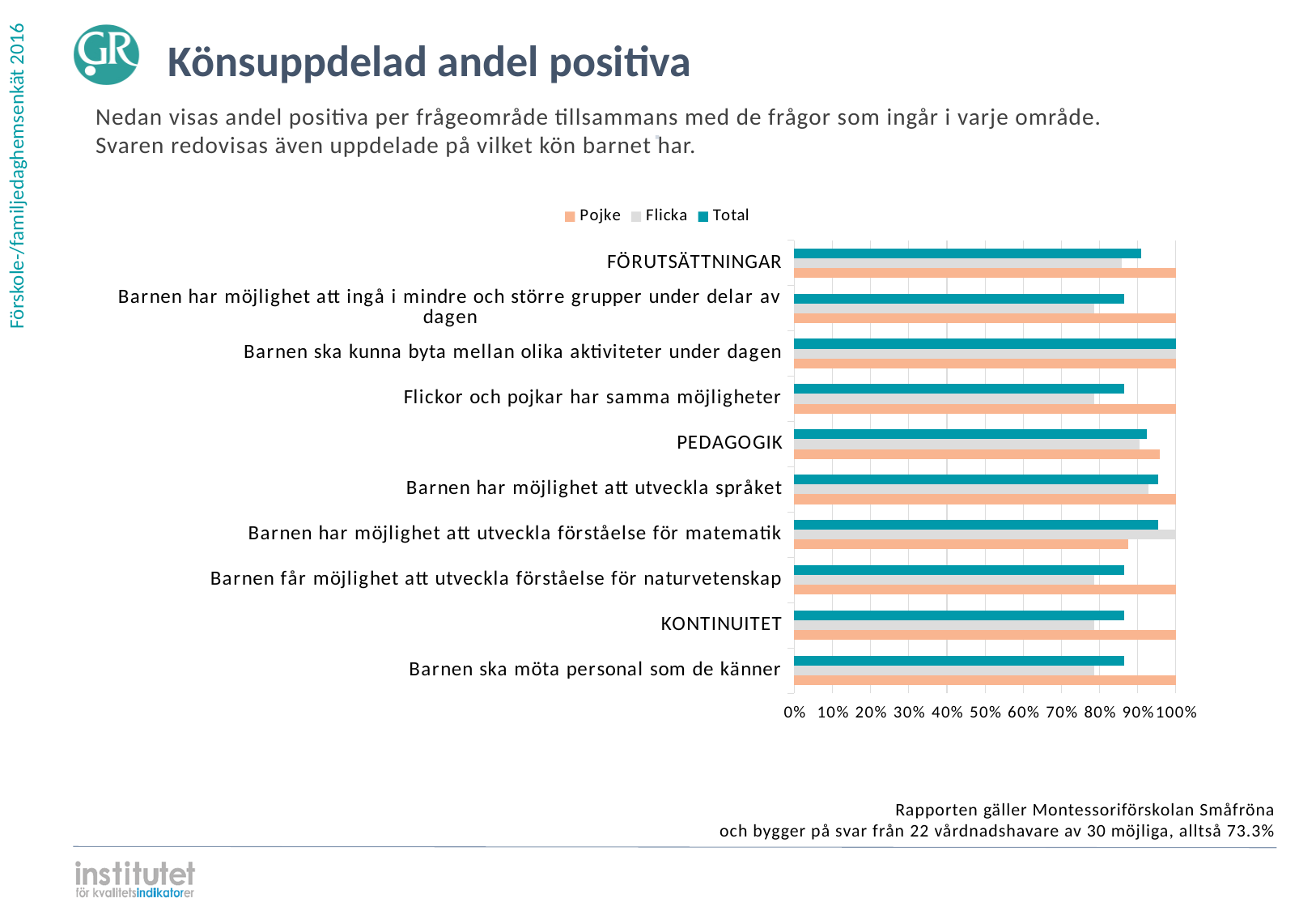
What is the Flicka value for 'Barnen har möjlighet att utveckla förståelse för matematik'? 100% Is the Total value for KONTINUITET greater or less than 80%? greater What kind of chart is shown on the slide? bar chart For 'Barnen har möjlighet att utveckla förståelse för matematik', which is larger: the Pojke value or the Flicka value? Flicka How many series does the legend list? 3 How many categories are plotted on the y axis of the chart? 10 What is the Pojke value for FÖRUTSÄTTNINGAR? 100% What is the Total value for 'Barnen ska kunna byta mellan olika aktiviteter under dagen'? 100% Is the Flicka value for FÖRUTSÄTTNINGAR greater or less than 80%? greater What are the three legend entries of the chart? Pojke, Flicka, Total For FÖRUTSÄTTNINGAR, which is larger: the Pojke value or the Flicka value? Pojke Is the Pojke value for PEDAGOGIK greater or less than 90%? greater